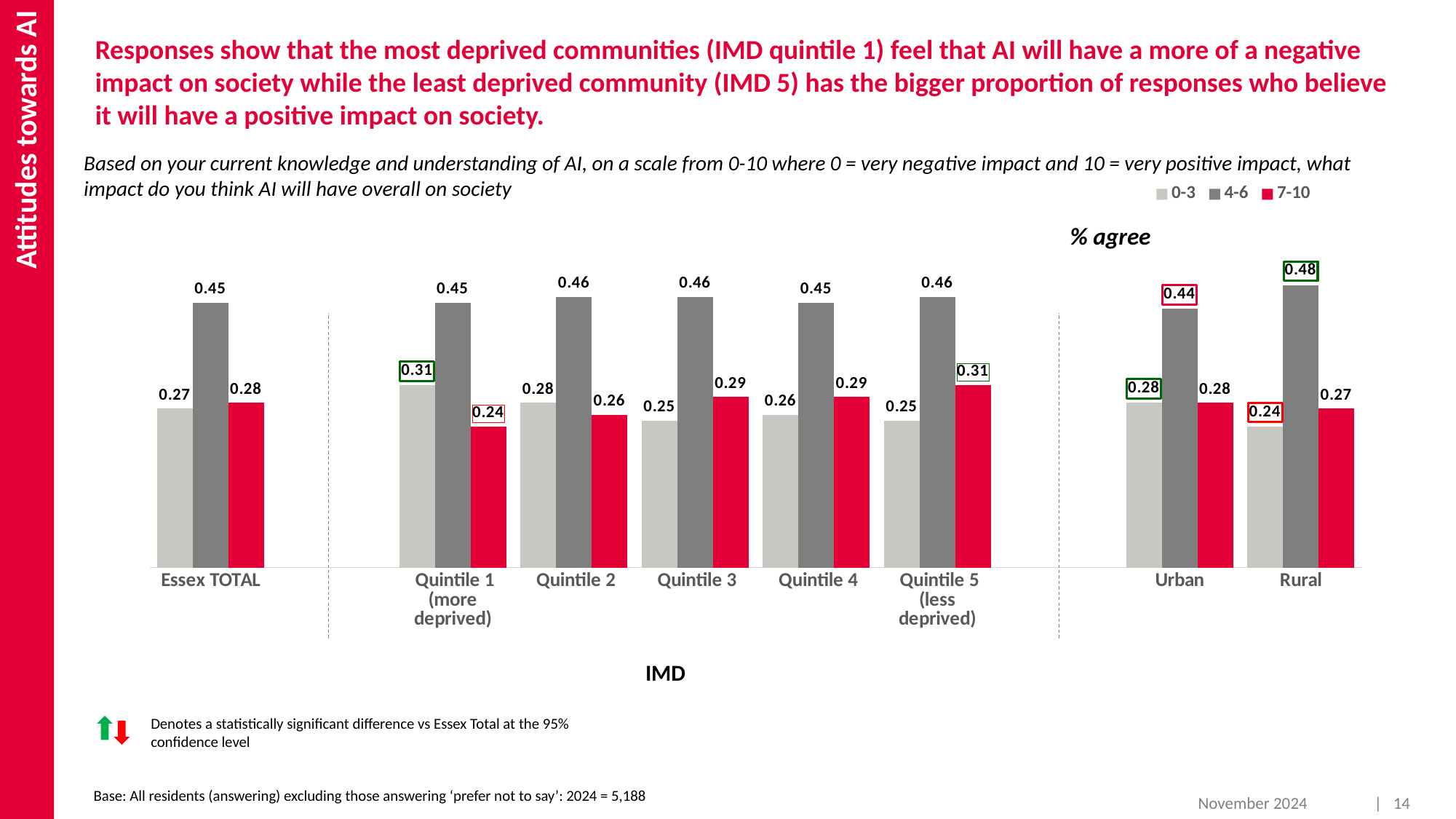
Which series is shown in red in the legend? 7-10 Which category has the lowest value in the 7-10 series? Quintile 1 (more deprived) Which is larger: the 0-3 value for Urban or the 0-3 value for Rural? Urban How many categories are shown on the x axis of the chart? 8 What is the value of the 0-3 series for Essex TOTAL? 0.27 What is the value of the 4-6 series for Rural? 0.48 What is the value of the 7-10 series for Quintile 5 (less deprived)? 0.31 What is the value of the 7-10 series for Quintile 1 (more deprived)? 0.24 Which category has the highest value in the 4-6 series? Rural What is the difference between the 7-10 values for Quintile 5 (less deprived) and Quintile 1 (more deprived)? 0.07 How many series does the legend list? 3 What kind of chart is shown on the slide? Bar chart